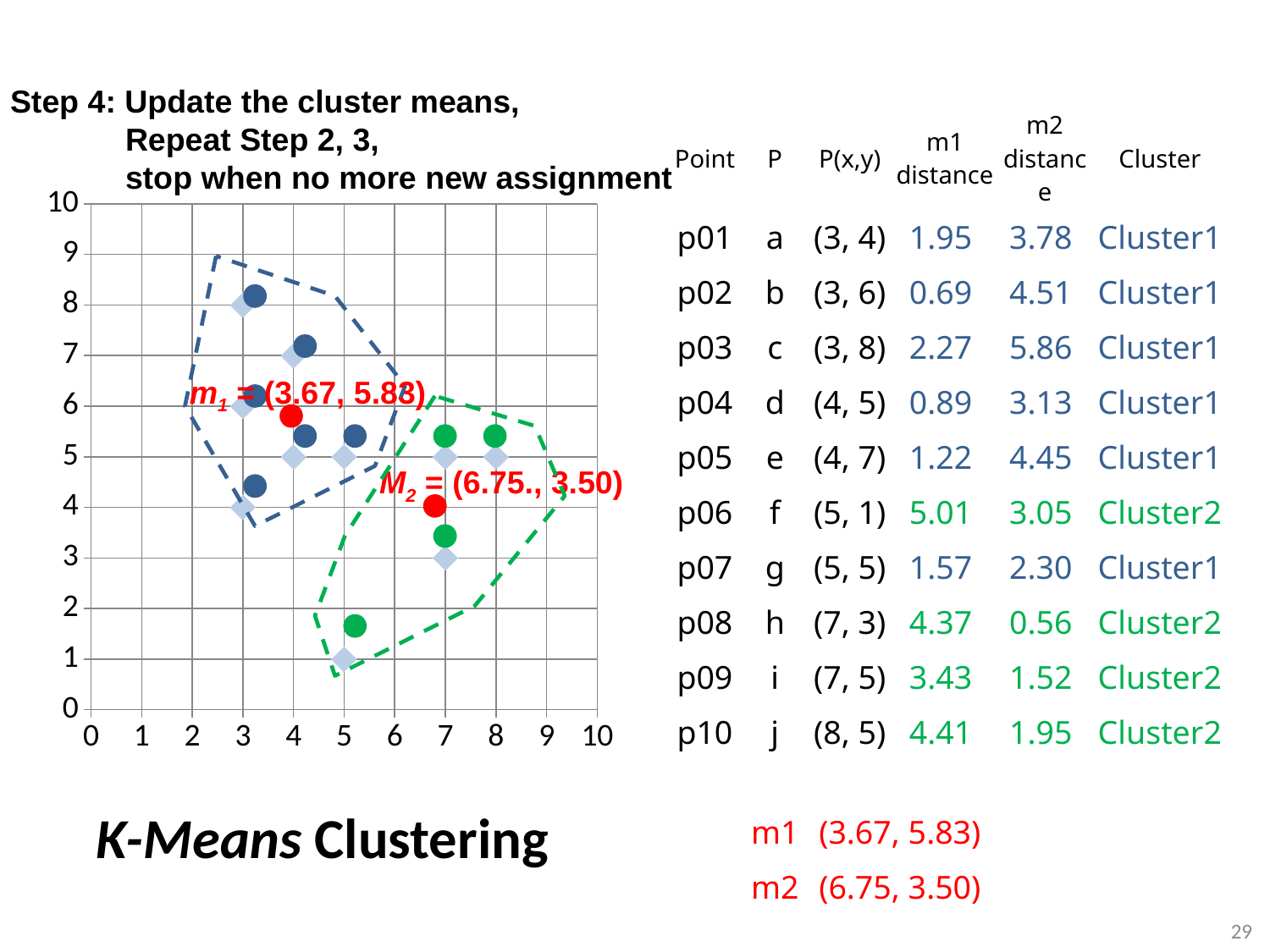
Which cluster mean has the larger y coordinate, m1 or M2? m1 What are the coordinates of the cluster mean m1 labelled on the chart? (3.67, 5.83) Which plotted data point has the lowest y value on the chart? (5, 1) Which plotted data point has the highest y value on the chart? (3, 8) Which cluster mean has the larger x coordinate, m1 or M2? M2 What are the coordinates of the cluster mean M2 labelled on the chart? (6.75, 3.50) Is the y coordinate of the cluster mean m1 greater or less than 5? greater What is the difference between the x coordinates of M2 and m1? 3.08 What kind of chart is shown on the left of the slide? scatter chart What is the highest value shown on the chart's y axis? 10 How many diamond-shaped data points are plotted on the chart? 10 Is the x coordinate of the cluster mean M2 greater or less than 6? greater